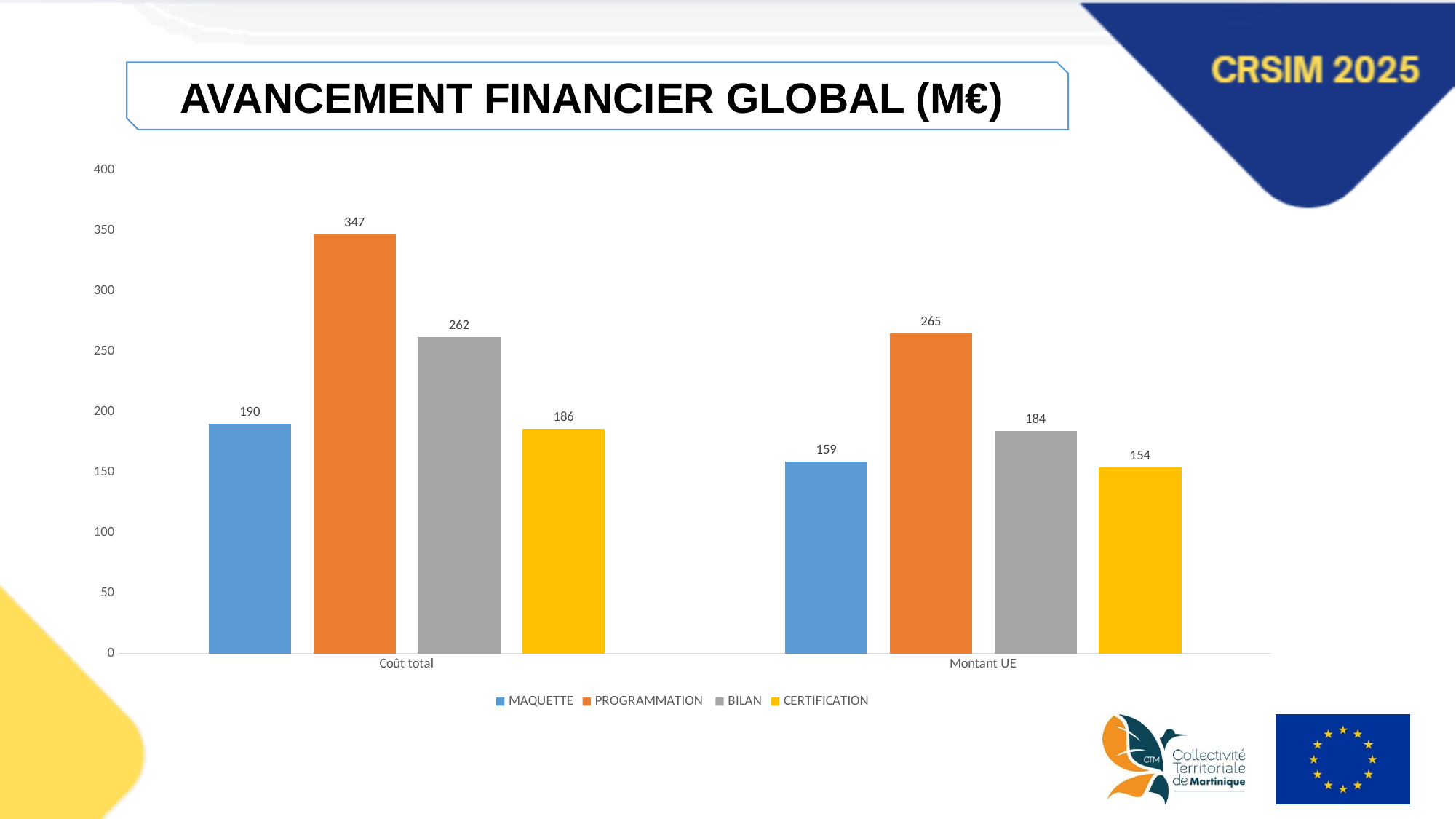
What is the MAQUETTE value for Montant UE? 159 What is the PROGRAMMATION value for Coût total? 347 What is the title of the chart? AVANCEMENT FINANCIER GLOBAL (M€) What is the difference between the PROGRAMMATION values for Coût total and Montant UE? 82 Which series has the lowest value for Montant UE? CERTIFICATION How many categories are shown on the x axis? 2 Which is larger: the MAQUETTE value for Coût total or the BILAN value for Montant UE? MAQUETTE value for Coût total What is the CERTIFICATION value for Montant UE? 154 How many series does the legend list? 4 What is the difference between the BILAN and CERTIFICATION values for Coût total? 76 Which series has the highest value for Coût total? PROGRAMMATION What kind of chart is shown on the slide? Bar chart